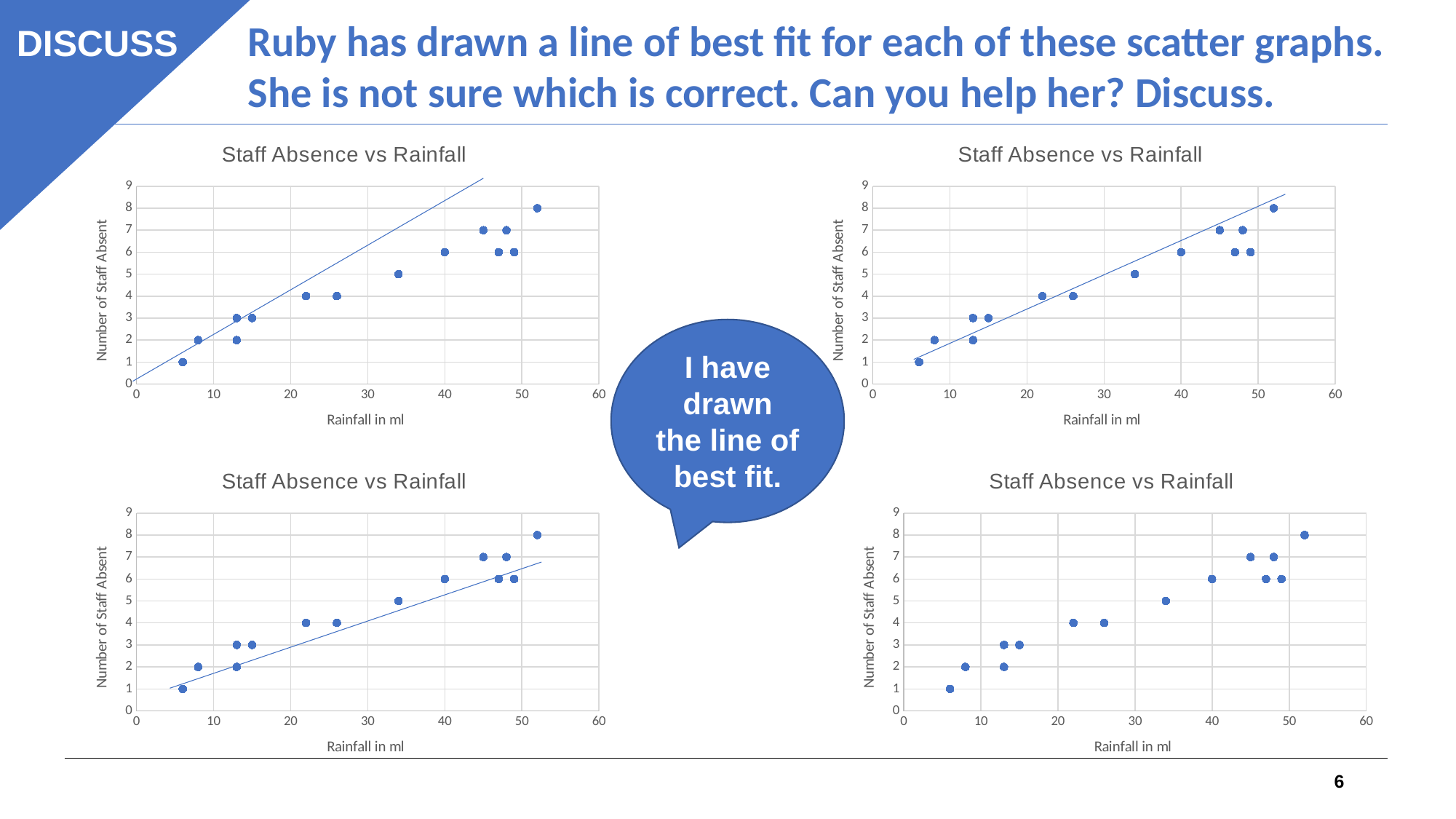
What is the title of the bottom-left chart? Staff Absence vs Rainfall In the top-right chart, is the rainfall for the point with 5 staff absent greater or less than 30? greater In the bottom-left chart, what is the lowest number of staff absent plotted? 1 In the top-right chart, what is the highest number of staff absent plotted? 8 In the bottom-left chart, which is larger: the number of staff absent at about 34 ml of rainfall or at about 22 ml of rainfall? 34 ml What kind of chart is the top-left chart? scatter chart In the top-left chart, is the rainfall for the point with 8 staff absent greater or less than 50? greater In the bottom-right chart, is the rainfall for the point with 1 staff absent greater or less than 10? less In the top-left chart, do the number of staff absent values rise or fall as rainfall increases? rise How many data points are plotted in the bottom-right chart? 14 What is the x-axis label on the top-right chart? Rainfall in ml